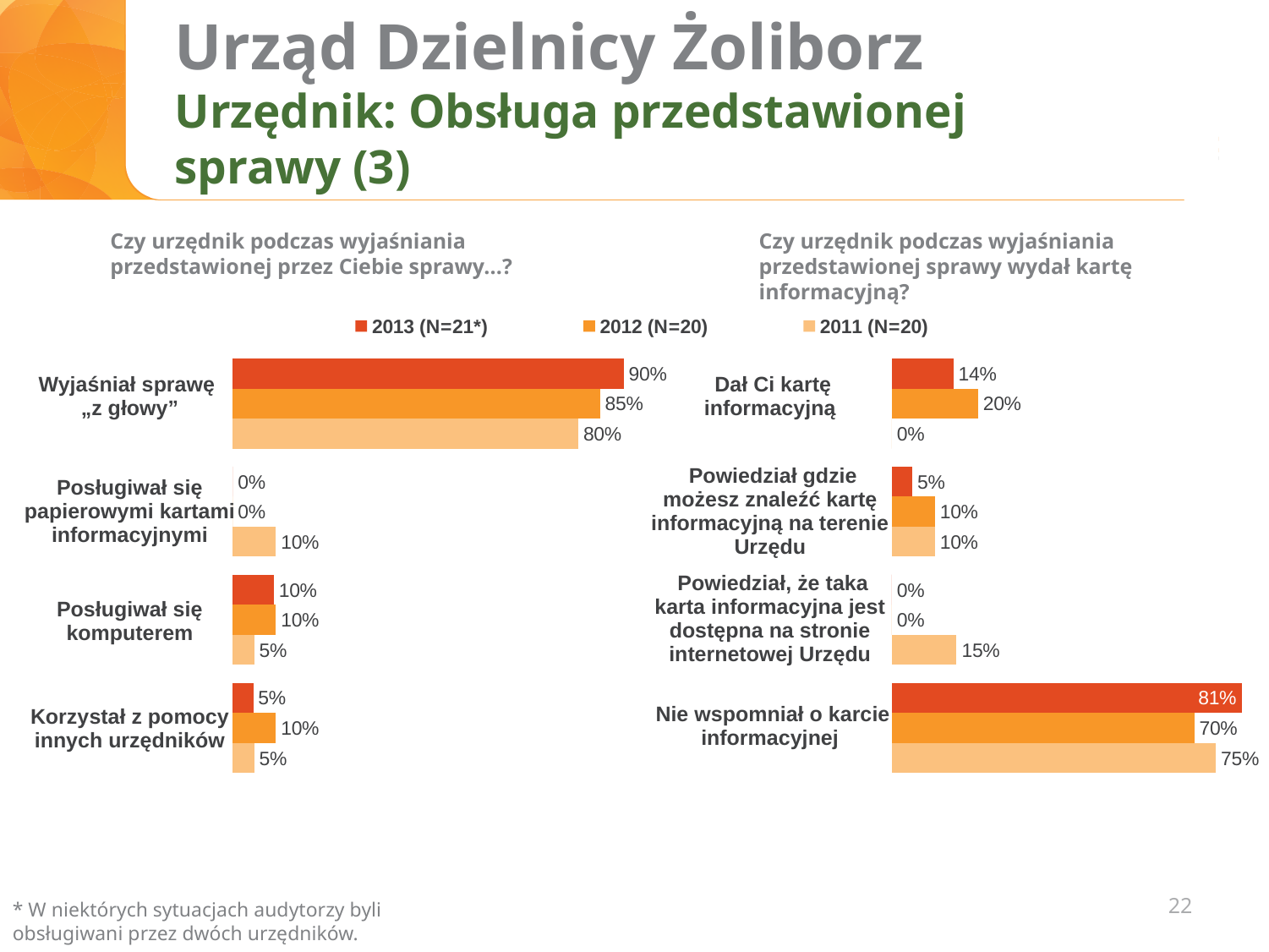
In the right chart, what is the difference between the 2013 and 2012 values for "Nie wspomniał o karcie informacyjnej"? 11% In the right chart, what is the 2012 value for "Dał Ci kartę informacyjną"? 20% In the right chart, which category has the highest 2013 value? Nie wspomniał o karcie informacyjnej In the left chart, which is larger for "Korzystał z pomocy innych urzędników": the 2012 value or the 2013 value? 2012 In the left chart, what is the 2011 value for "Posługiwał się papierowymi kartami informacyjnymi"? 10% How many series does the legend list? 3 What sample size is given for the 2013 series in the legend? N=21* In the right chart, what is the 2011 value for "Powiedział, że taka karta informacyjna jest dostępna na stronie internetowej Urzędu"? 15% How many categories does the left chart show? 4 What type of chart is the right chart? Bar chart In the left chart, what is the difference between the 2013 and 2011 values for "Wyjaśniał sprawę „z głowy”"? 10% In the left chart, what is the 2013 value for "Wyjaśniał sprawę „z głowy”"? 90%